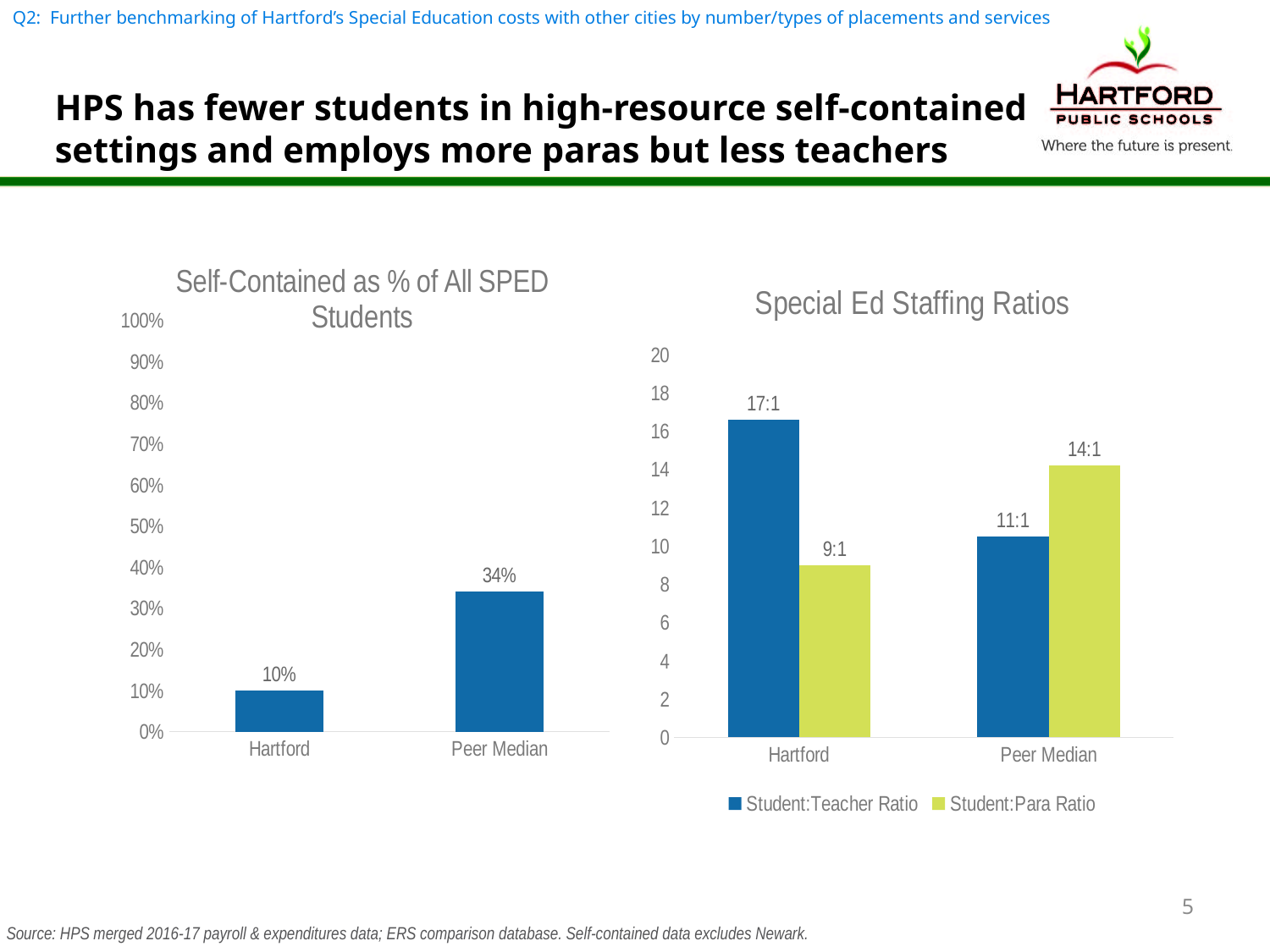
In the 'Special Ed Staffing Ratios' chart, what is the Student:Teacher Ratio for Hartford? 17:1 In the 'Self-Contained as % of All SPED Students' chart, what is the value for Hartford? 10% In the 'Self-Contained as % of All SPED Students' chart, what is the value for Peer Median? 34% In the 'Special Ed Staffing Ratios' chart, how many series does the legend list? 2 In the 'Self-Contained as % of All SPED Students' chart, how many categories are shown on the x axis? 2 In the 'Special Ed Staffing Ratios' chart, what is the Student:Para Ratio for Peer Median? 14:1 In the 'Special Ed Staffing Ratios' chart, what is the Student:Para Ratio for Hartford? 9:1 In the 'Self-Contained as % of All SPED Students' chart, which category has the higher value? Peer Median In the 'Special Ed Staffing Ratios' chart, is the Student:Teacher Ratio for Hartford greater or less than 16? greater In the 'Self-Contained as % of All SPED Students' chart, what is the difference between the Peer Median and Hartford values? 24% In the 'Special Ed Staffing Ratios' chart, which is larger for Peer Median: the Student:Teacher Ratio or the Student:Para Ratio? Student:Para Ratio What kind of chart is the 'Special Ed Staffing Ratios' chart? Bar chart